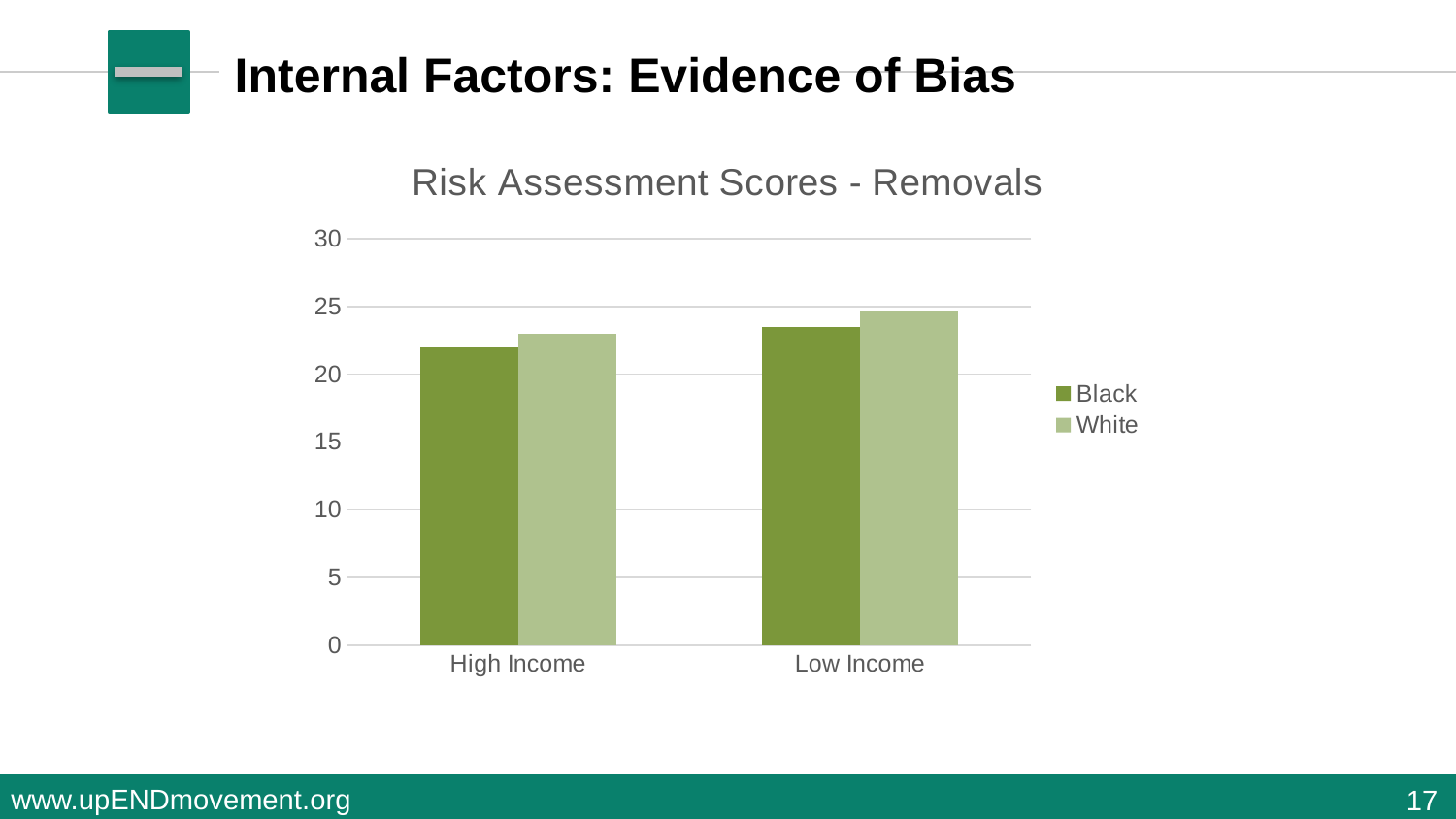
What is the title of the chart? Risk Assessment Scores - Removals How many categories are shown on the x axis? 2 Is the value for Black in the High Income category greater or less than 20? greater How many series does the legend list? 2 What type of chart is shown on the slide? Bar chart Which bar is the tallest in the chart? White, Low Income Is the value for Black in the Low Income category greater or less than 25? less Which series does the legend list first? Black In the High Income category, which series has the larger value, Black or White? White Do the Black series values rise or fall from High Income to Low Income? rise Is the value for White in the Low Income category greater or less than 20? greater